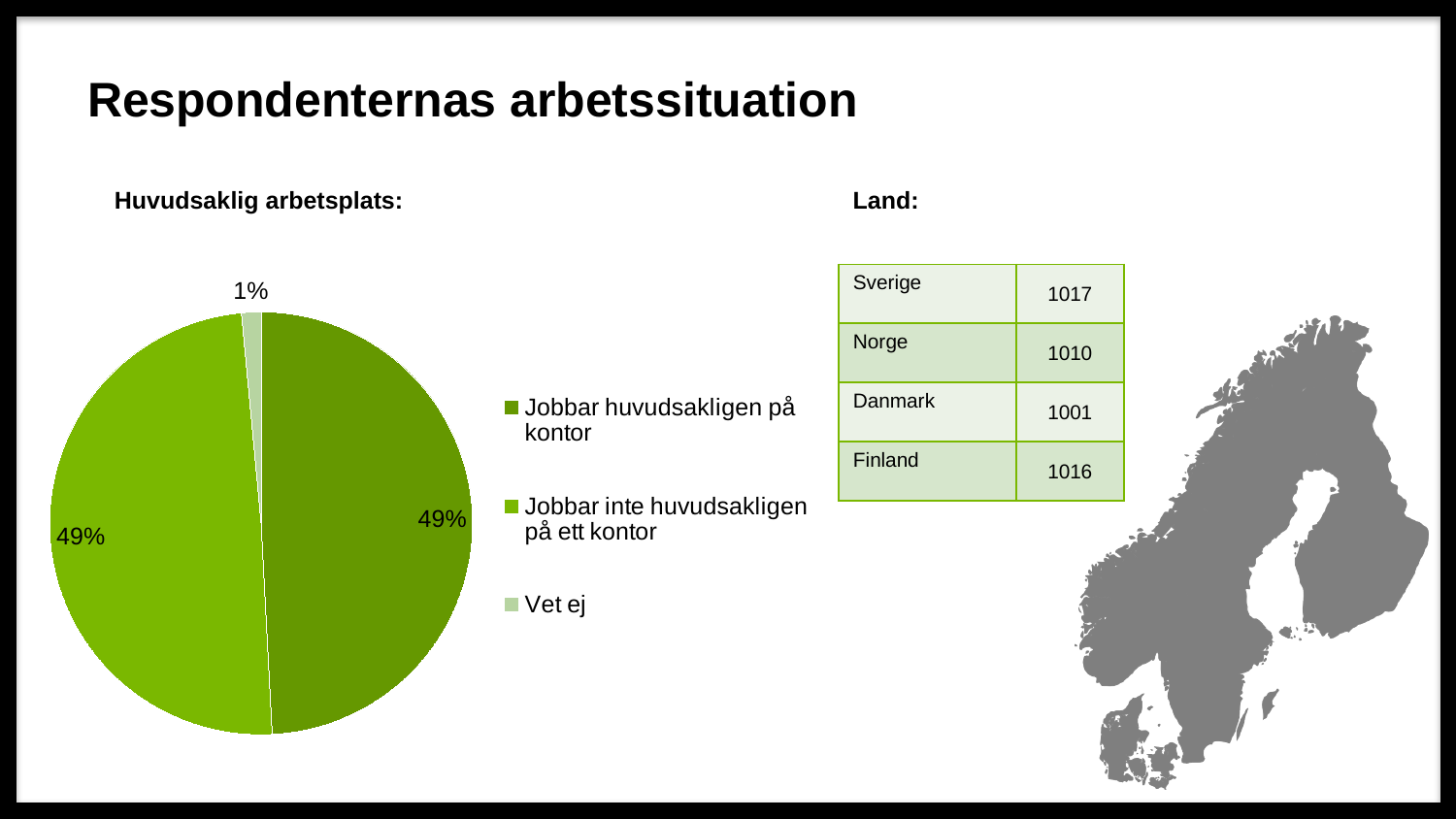
Which is larger in the pie chart: "Vet ej" or "Jobbar huvudsakligen på kontor"? Jobbar huvudsakligen på kontor How many entries does the pie chart's legend list? 3 What percentage of the pie chart is "Jobbar huvudsakligen på kontor"? 49% Which category has the smallest slice in the pie chart? Vet ej How many slices does the pie chart have? 3 Which legend entry of the pie chart is shown in the lightest colour? Vet ej What percentage of the pie chart is "Vet ej"? 1% What do the two 49% slices of the pie chart add up to? 98% What is the heading shown above the pie chart? Huvudsaklig arbetsplats: What kind of chart is shown under "Huvudsaklig arbetsplats:"? Pie chart What is the difference in percentage points between "Jobbar huvudsakligen på kontor" and "Vet ej" in the pie chart? 48 percentage points What percentage of the pie chart is "Jobbar inte huvudsakligen på ett kontor"? 49%